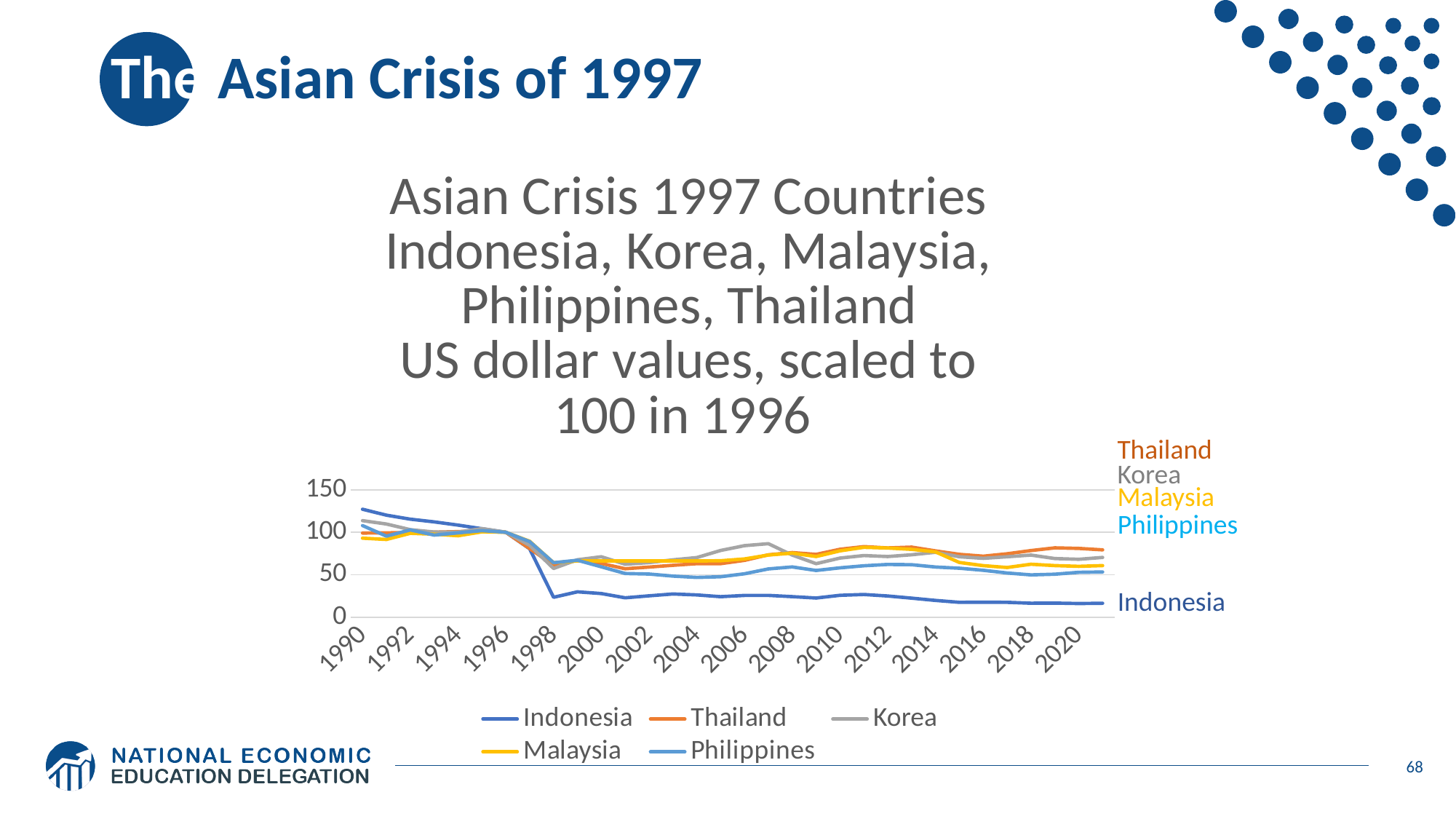
What kind of chart is shown on the slide? line chart In 2020, which is larger: the value for Thailand or the value for Indonesia? Thailand What value do all five series take in 1996? 100 Which countries are listed in the chart's legend? Indonesia, Thailand, Korea, Malaysia, Philippines Is the value for Indonesia in 2020 greater or less than 50? less Which series has the lowest value in 2020? Indonesia How many series does the chart's legend list? 5 Which series has the highest value in 1990? Indonesia According to the chart title, in which year are the US dollar values scaled to 100? 1996 Is the value for Thailand in 2020 greater or less than 50? greater Does the Indonesia series rise or fall from 1990 to 2020? fall Is the value for Indonesia in 1990 greater or less than 100? greater